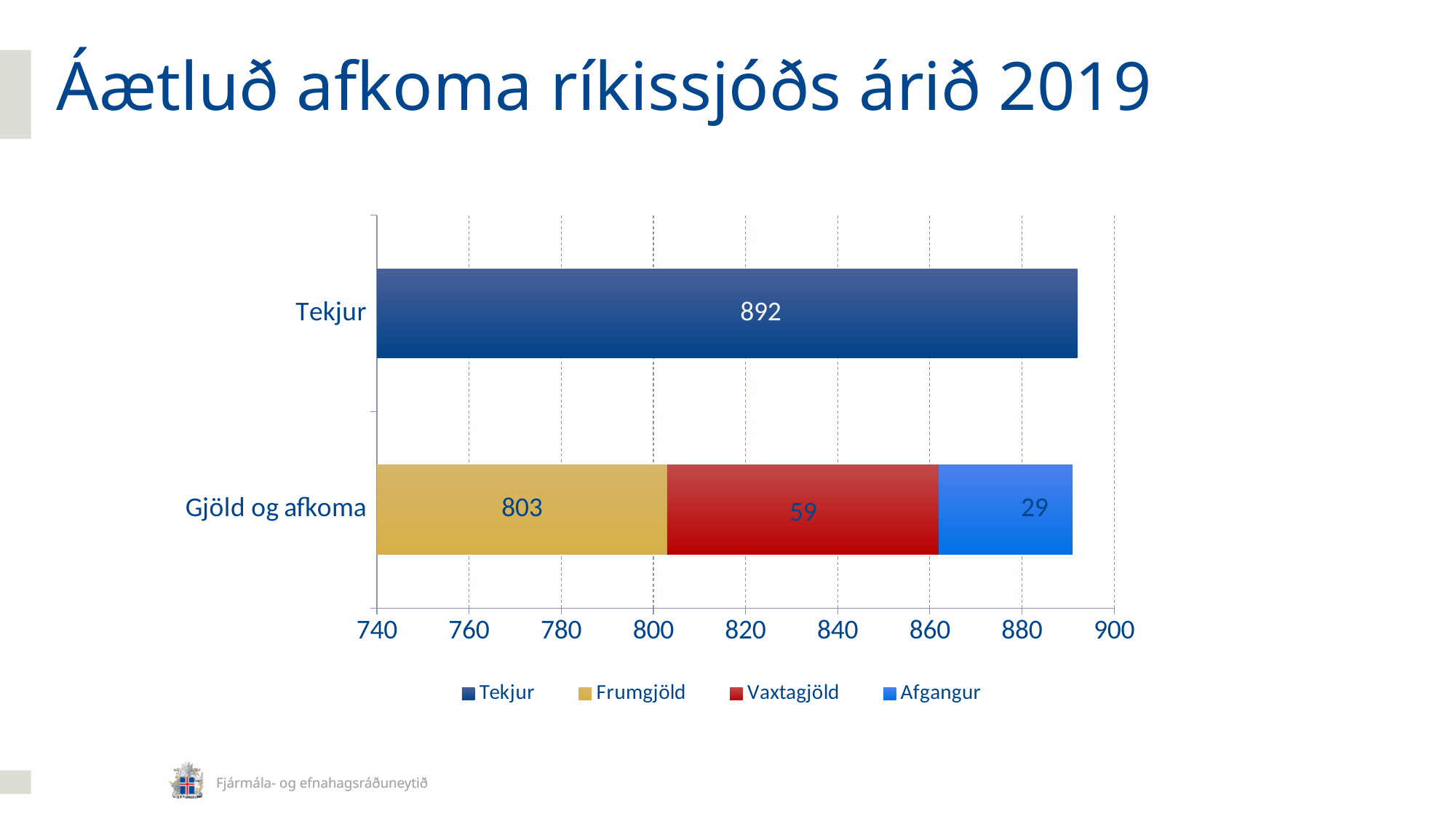
How many categories are shown on the vertical axis? 2 What is the value of Vaxtagjöld in the Gjöld og afkoma bar? 59 What kind of chart is shown on the slide? Bar chart What is the value of Afgangur in the Gjöld og afkoma bar? 29 Which is larger, Vaxtagjöld or Afgangur? Vaxtagjöld How many series does the legend list? 4 What is the difference between the Vaxtagjöld value and the Afgangur value? 30 What is the difference between the Tekjur value and the Frumgjöld value? 89 What is the total of the stacked Gjöld og afkoma bar (Frumgjöld + Vaxtagjöld + Afgangur)? 891 What is the title of the slide? Áætluð afkoma ríkissjóðs árið 2019 What is the value of Frumgjöld in the Gjöld og afkoma bar? 803 What is the value of the Tekjur bar? 892